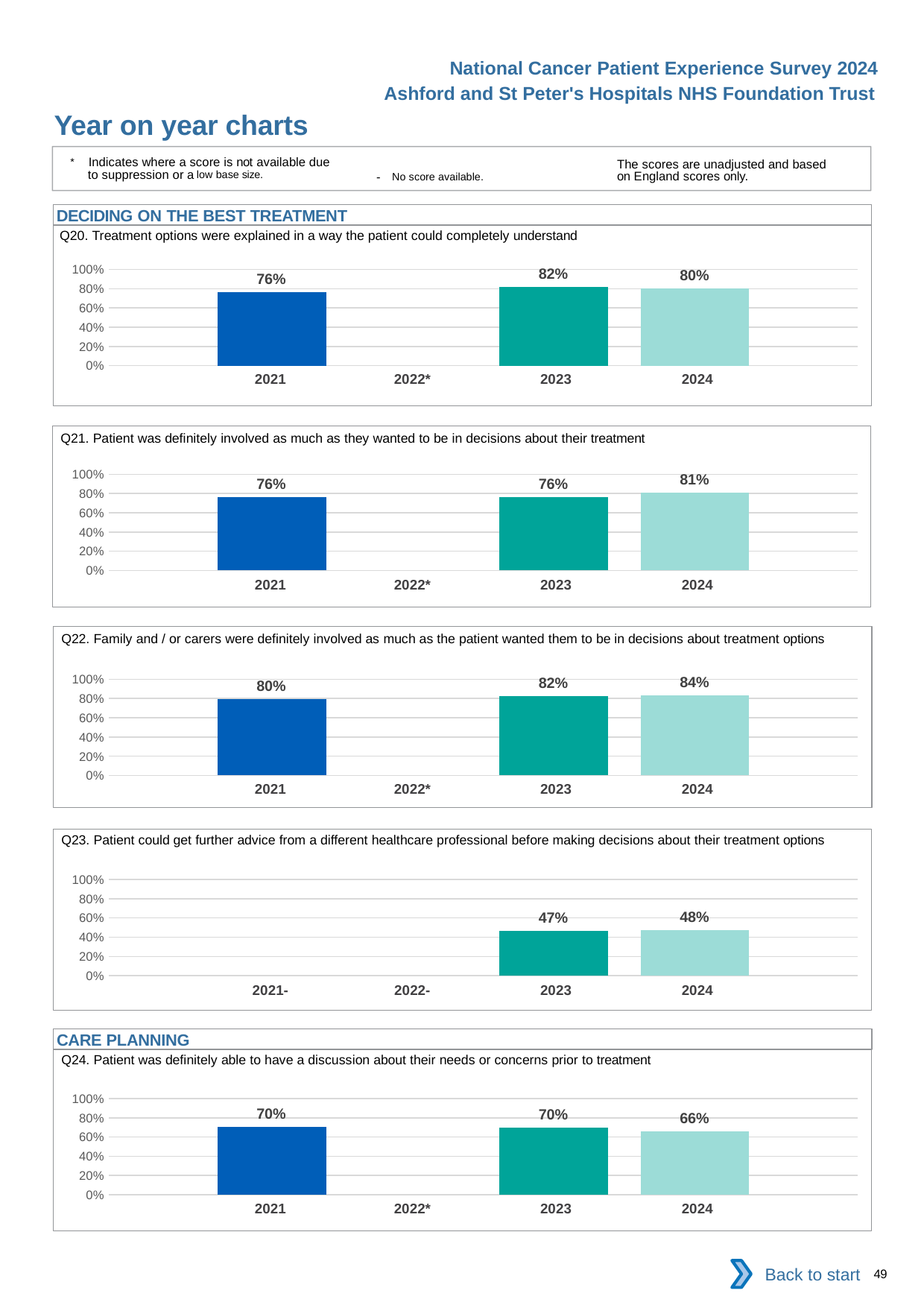
In the Q21 chart, what is the value for 2024? 81% What kind of chart is the Q20 chart? Bar chart In the Q22 chart, what is the value for 2024? 84% In the Q23 chart, is the value for 2024 greater or less than 60%? less In the Q21 chart, what is the difference between the 2024 and 2023 values? 5% In the Q20 chart, what is the value for 2023? 82% In the Q20 chart, which year has the highest value? 2023 In the Q22 chart, which year has the lowest value? 2021 In the Q23 chart, what is the value for 2023? 47% In the Q24 chart, which is larger, the value for 2023 or the value for 2024? 2023 How many years are shown on the x axis of the Q22 chart? 4 In the Q24 chart, what is the difference between the 2021 and 2024 values? 4%